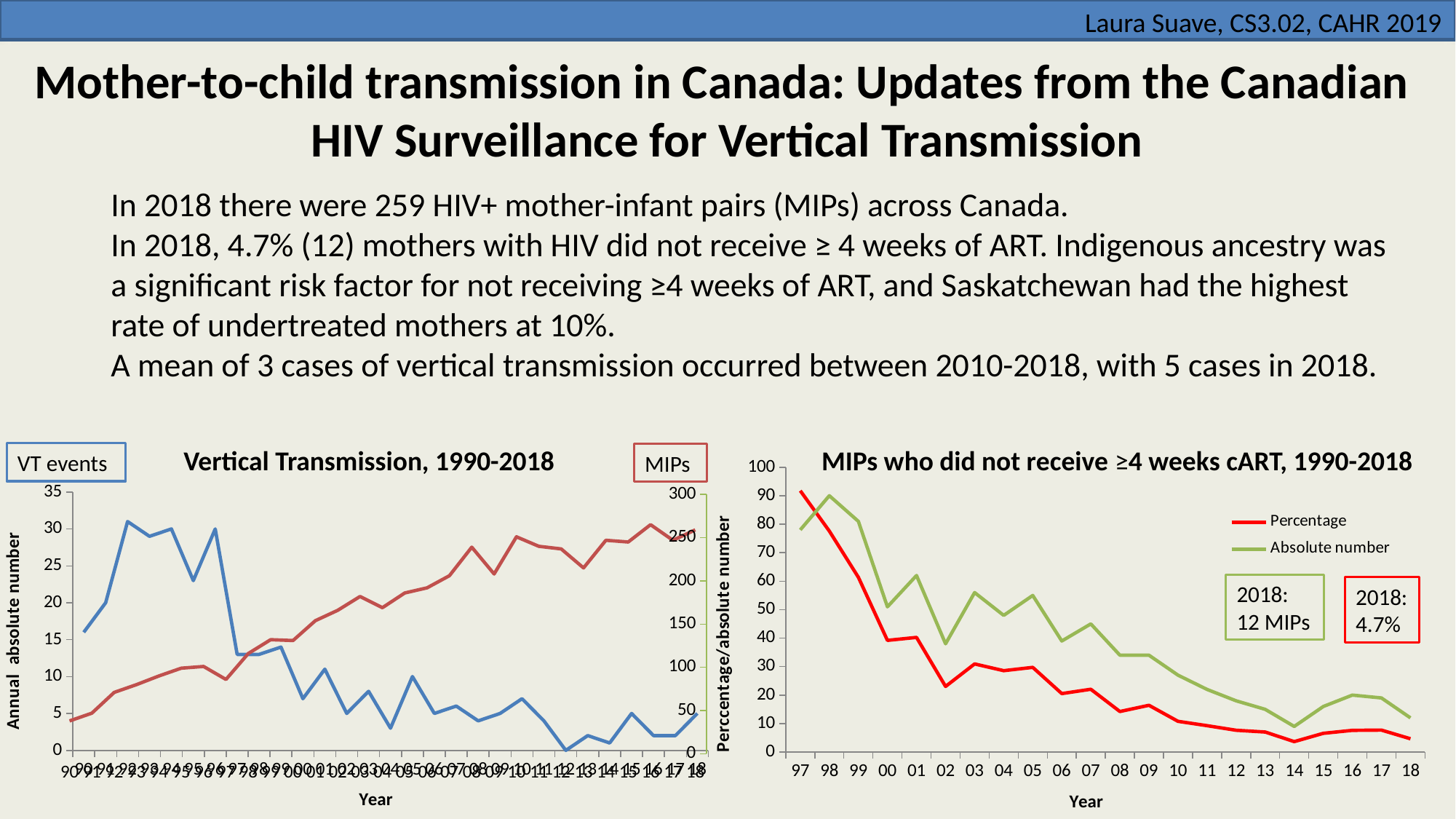
In the right chart, 'MIPs who did not receive ≥4 weeks cART, 1990-2018', what is the absolute number of MIPs in 2018? 12 MIPs What kind of chart is the 'Vertical Transmission, 1990-2018' chart on the left? Line chart In the left chart, 'Vertical Transmission, 1990-2018', does the MIPs series generally rise or fall from 1990 to 2018? Rise In the right chart, 'MIPs who did not receive ≥4 weeks cART, 1990-2018', does the Percentage series rise or fall from 1997 to 2018? Fall In the left chart, 'Vertical Transmission, 1990-2018', which series is drawn in blue? VT events In the right chart, 'MIPs who did not receive ≥4 weeks cART, 1990-2018', which year has the highest Percentage value? 97 In the left chart, 'Vertical Transmission, 1990-2018', is the MIPs value for 2018 greater or less than 200? greater In the left chart, 'Vertical Transmission, 1990-2018', does the VT events series generally rise or fall from 1992 to 2018? Fall In the right chart, 'MIPs who did not receive ≥4 weeks cART, 1990-2018', is the Absolute number for 1998 greater or less than 80? greater How many series does the legend of the right chart, 'MIPs who did not receive ≥4 weeks cART, 1990-2018', list? 2 In the right chart, 'MIPs who did not receive ≥4 weeks cART, 1990-2018', which series is larger in 1997, Percentage or Absolute number? Percentage In the right chart, 'MIPs who did not receive ≥4 weeks cART, 1990-2018', what is the percentage in 2018? 4.7%